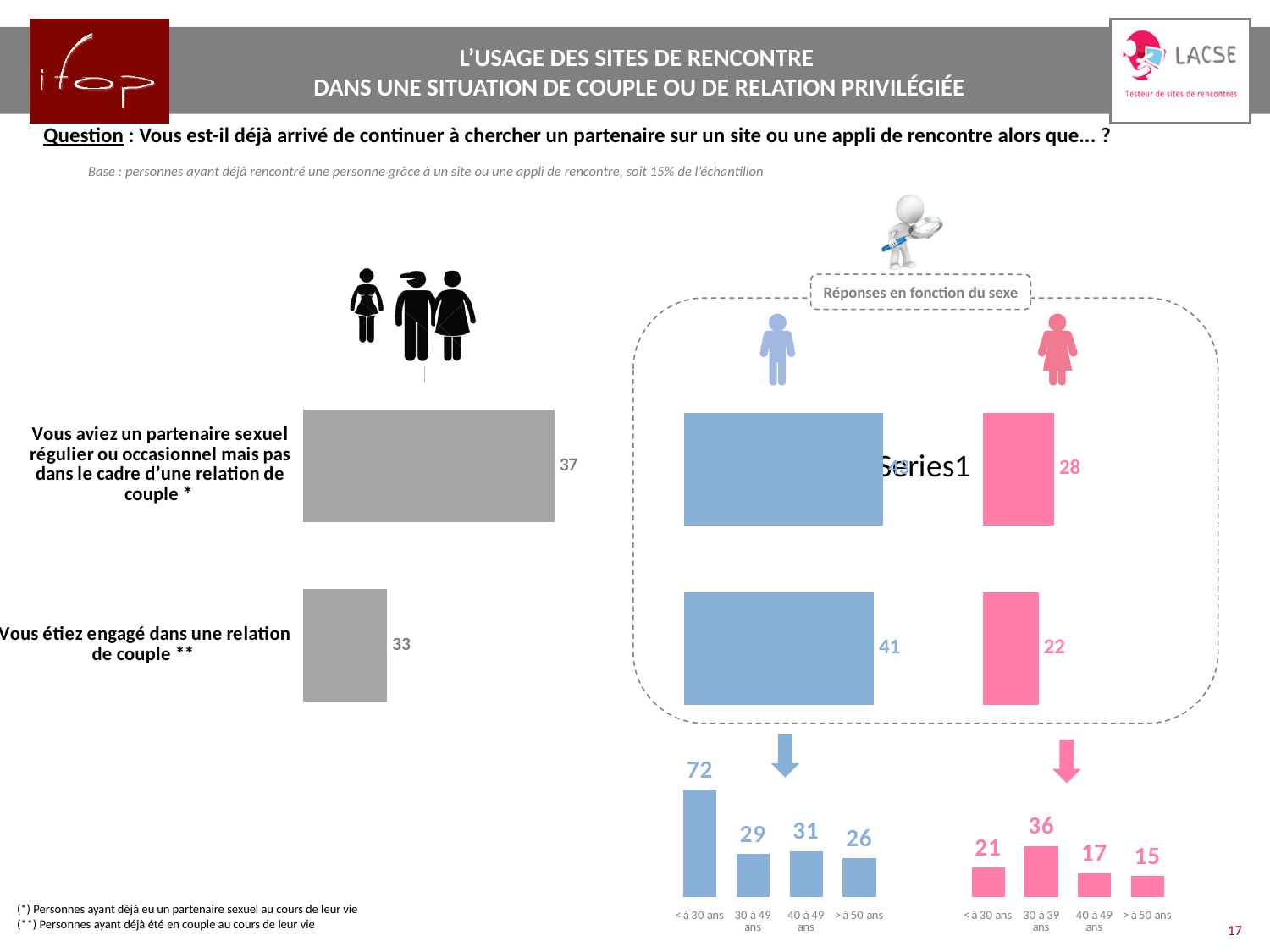
How many age groups are shown in the pink age-group bar chart at the bottom? 4 In the blue age-group bar chart at the bottom, what is the value for "< à 30 ans"? 72 In the grey bar chart on the left, what is the value for "Vous étiez engagé dans une relation de couple"? 33 In the grey bar chart on the left, which category has the higher value? Vous aviez un partenaire sexuel régulier ou occasionnel mais pas dans le cadre d'une relation de couple For "Vous étiez engagé dans une relation de couple", which is larger: the blue (men) value or the pink (women) value? blue (men), 41 In the blue (men) bar chart in the dashed box, what is the value for "Vous étiez engagé dans une relation de couple"? 41 In the pink age-group bar chart at the bottom, which age group has the highest value? 30 à 39 ans In the grey bar chart on the left, what is the value for "Vous aviez un partenaire sexuel régulier ou occasionnel mais pas dans le cadre d'une relation de couple"? 37 In the grey bar chart on the left, what is the difference between the two bars? 4 In the pink (women) bar chart in the dashed box, what is the value for "Vous aviez un partenaire sexuel régulier ou occasionnel"? 28 In the blue age-group bar chart at the bottom, which age group has the lowest value? > à 50 ans In the pink (women) bar chart in the dashed box, what is the value for "Vous étiez engagé dans une relation de couple"? 22